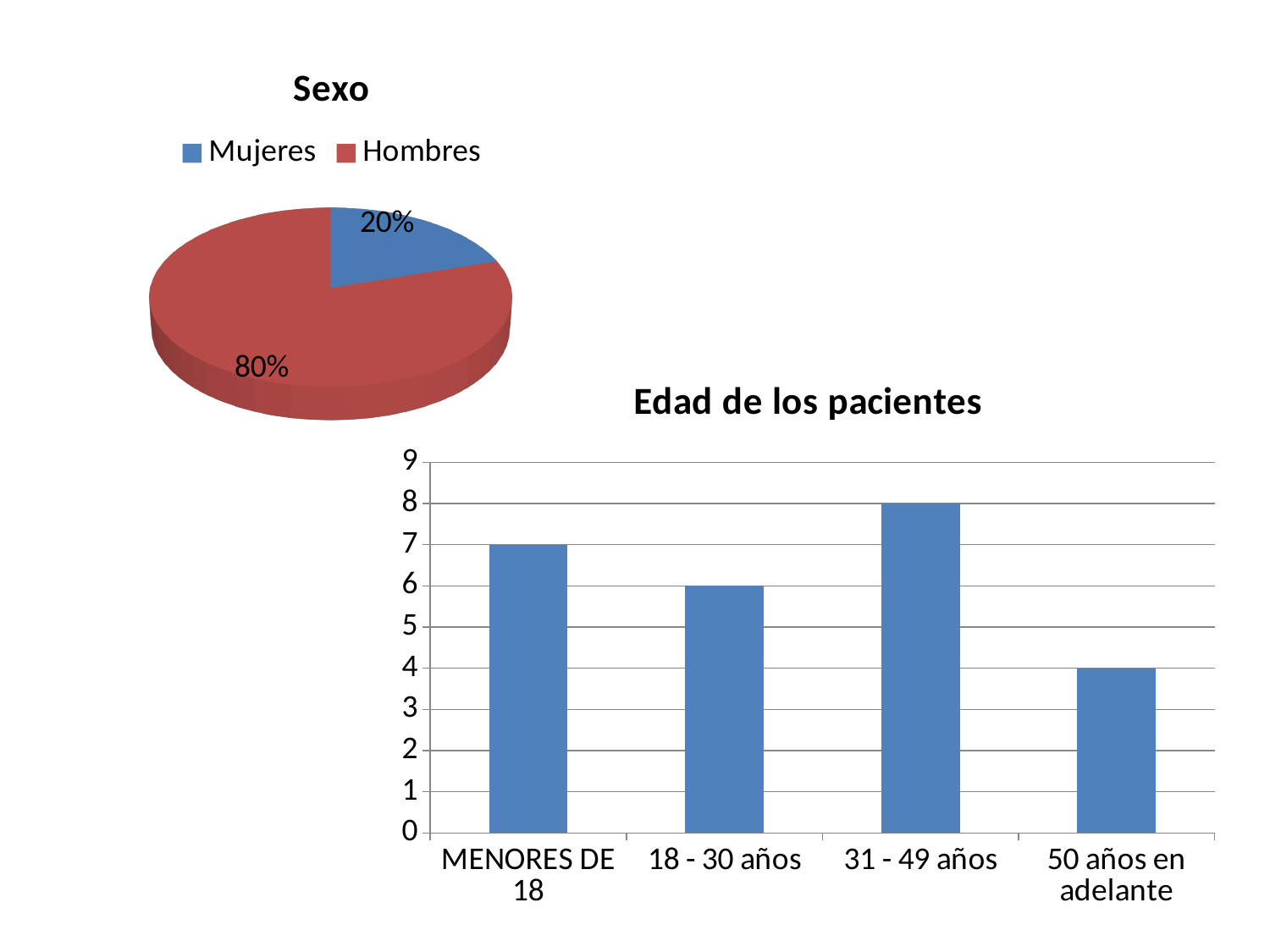
In the 'Sexo' chart, what share of the pie is Hombres? 80% In the 'Sexo' chart, what share of the pie is Mujeres? 20% How many categories are shown in the 'Edad de los pacientes' chart? 4 What kind of chart is the 'Edad de los pacientes' chart? Bar chart In the 'Edad de los pacientes' chart, what is the value for 50 años en adelante? 4 How many entries does the legend of the 'Sexo' chart list? 2 In the 'Edad de los pacientes' chart, which category has the lowest value? 50 años en adelante In the 'Sexo' chart, which slice is larger, Mujeres or Hombres? Hombres In the 'Edad de los pacientes' chart, what is the value for 31 - 49 años? 8 In the 'Edad de los pacientes' chart, what is the difference between the values for MENORES DE 18 and 18 - 30 años? 1 In the 'Edad de los pacientes' chart, which category has the highest value? 31 - 49 años What kind of chart is the 'Sexo' chart? Pie chart